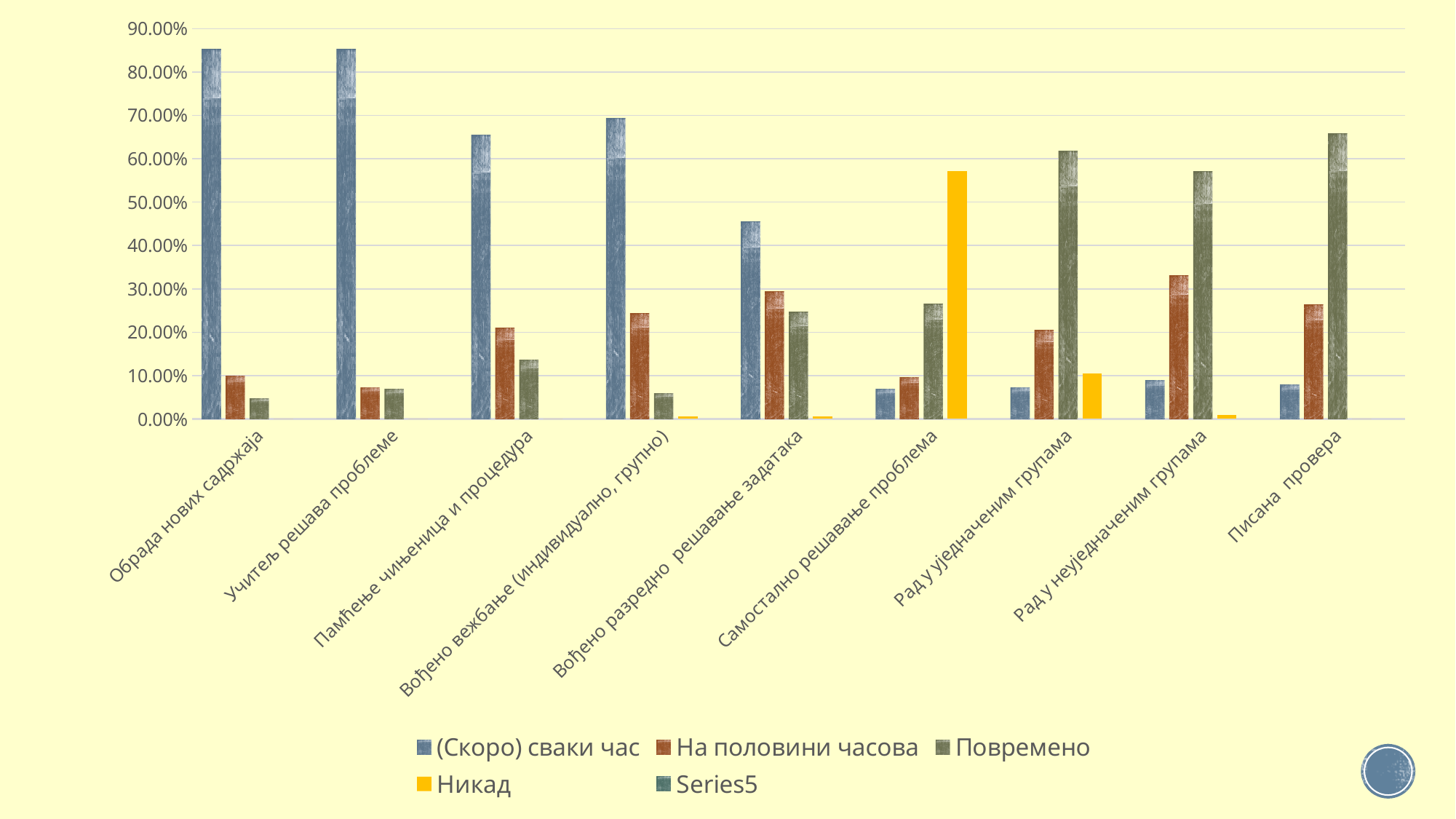
How many categories are shown along the x axis? 9 Which category has the highest value for Повремено? Писана провера What colour represents the Никад series in the legend? yellow Is the value of Никад for Самостално решавање проблема greater or less than 50.00%? greater Which category has the highest value for Никад? Самостално решавање проблема Is the value of (Скоро) сваки час for Вођено разредно решавање задатака greater or less than 40.00%? greater What kind of chart is shown on the slide? bar chart Which is larger for (Скоро) сваки час: Памћење чињеница и процедура or Вођено разредно решавање задатака? Памћење чињеница и процедура Is the value of Повремено for Обрада нових садржаја greater or less than 10.00%? less How many series does the legend list? 5